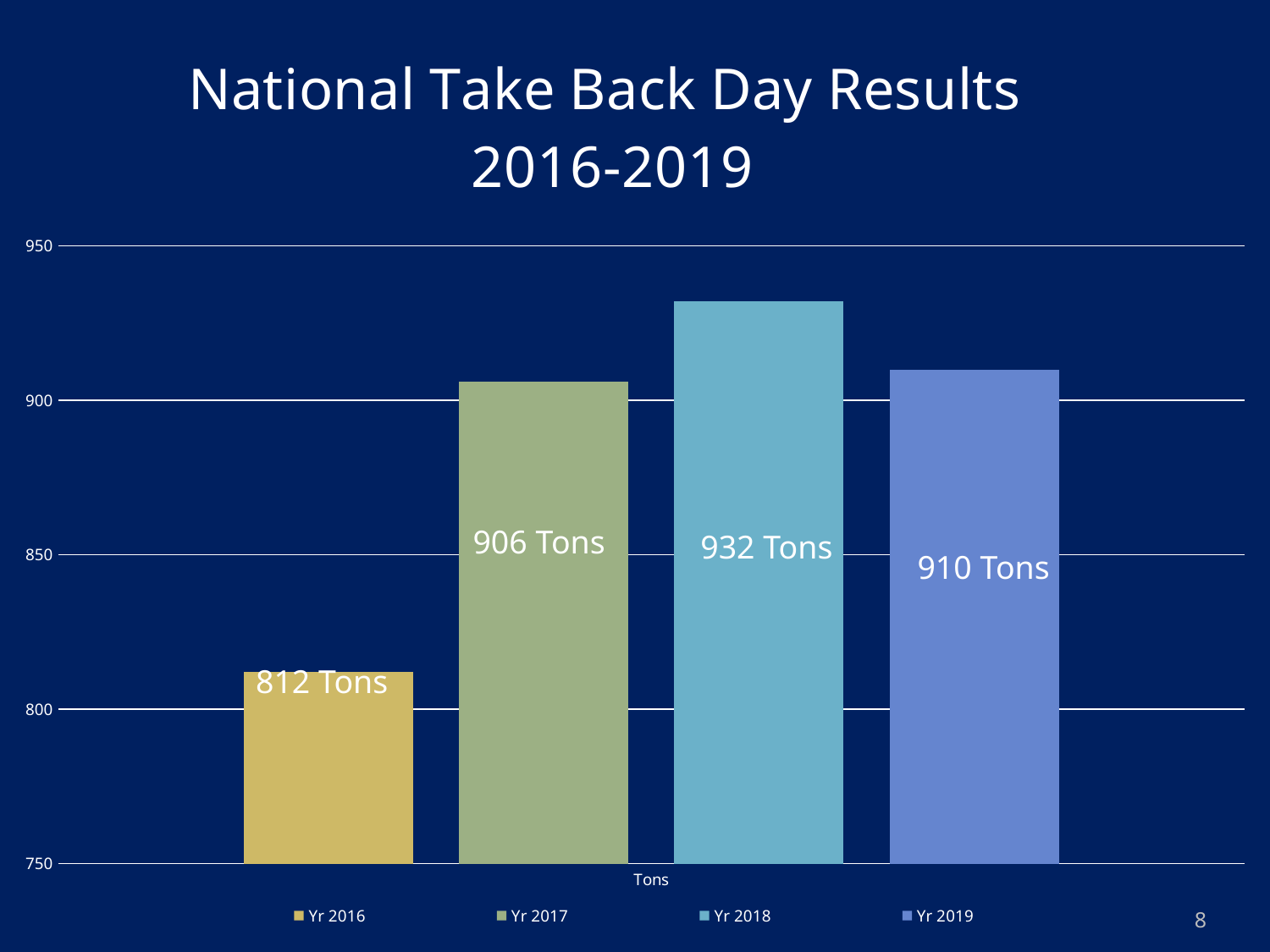
What value is shown for Yr 2018? 932 Tons Which is larger, the value for Yr 2017 or the value for Yr 2019? Yr 2019 What is the title of the chart on the slide? National Take Back Day Results 2016-2019 Which year has the highest value? Yr 2018 Which year has the lowest value? Yr 2016 What kind of chart is shown on the slide? bar chart What is the difference between the Yr 2018 and Yr 2016 values? 120 Tons What value is shown for Yr 2016? 812 Tons What is the difference between the Yr 2019 and Yr 2017 values? 4 Tons How many bars are plotted in the chart? 4 What value is shown for Yr 2019? 910 Tons Is the value for Yr 2016 greater or less than 850? less